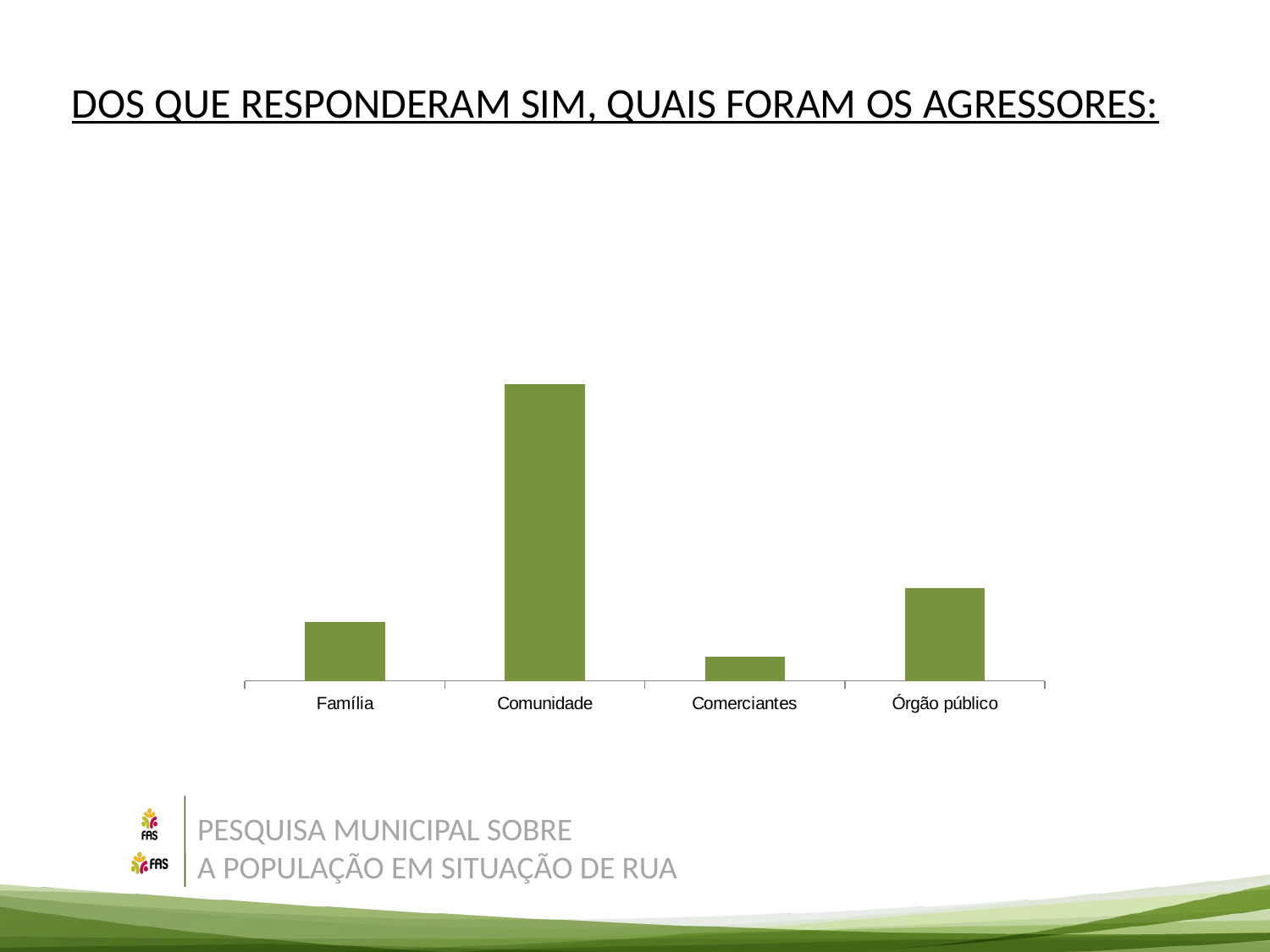
Which category has the lowest bar in the chart? Comerciantes What colour are the bars in the chart? Green What is the title of the slide above the chart? DOS QUE RESPONDERAM SIM, QUAIS FORAM OS AGRESSORES: Which category has the highest bar in the chart? Comunidade Which bar is taller, Família or Comerciantes? Família What kind of chart is shown on the slide? Bar chart Which bar is taller, Família or Órgão público? Órgão público Which category is shown second from the left on the x axis? Comunidade Which bar is taller, Comunidade or Órgão público? Comunidade How many categories are shown on the x axis of the chart? 4